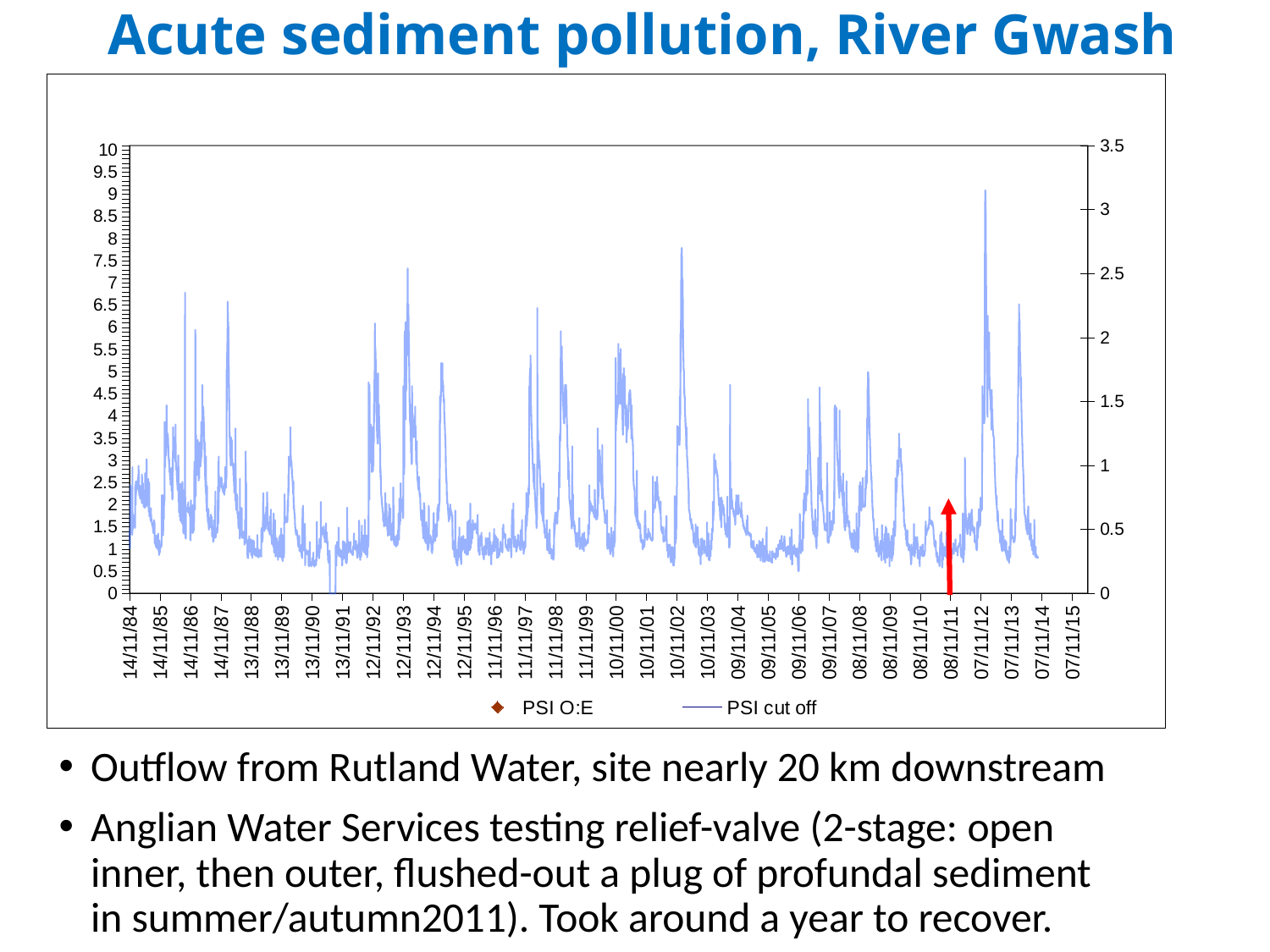
What kind of chart is shown on the slide? line chart What is the maximum value shown on the left y axis? 10 What are the two entries in the chart legend? PSI O:E and PSI cut off Is the peak near 10/11/02 greater or less than 7 on the left axis? greater Is the highest peak of the plotted series greater or less than 8 on the left axis? greater What is the title of the slide containing the chart? Acute sediment pollution, River Gwash What is the first date label on the x axis? 14/11/84 What is the last date label on the x axis? 07/11/15 What is the maximum value shown on the right y axis? 3.5 How many date labels are shown along the x axis? 32 How many series does the chart legend list? 2